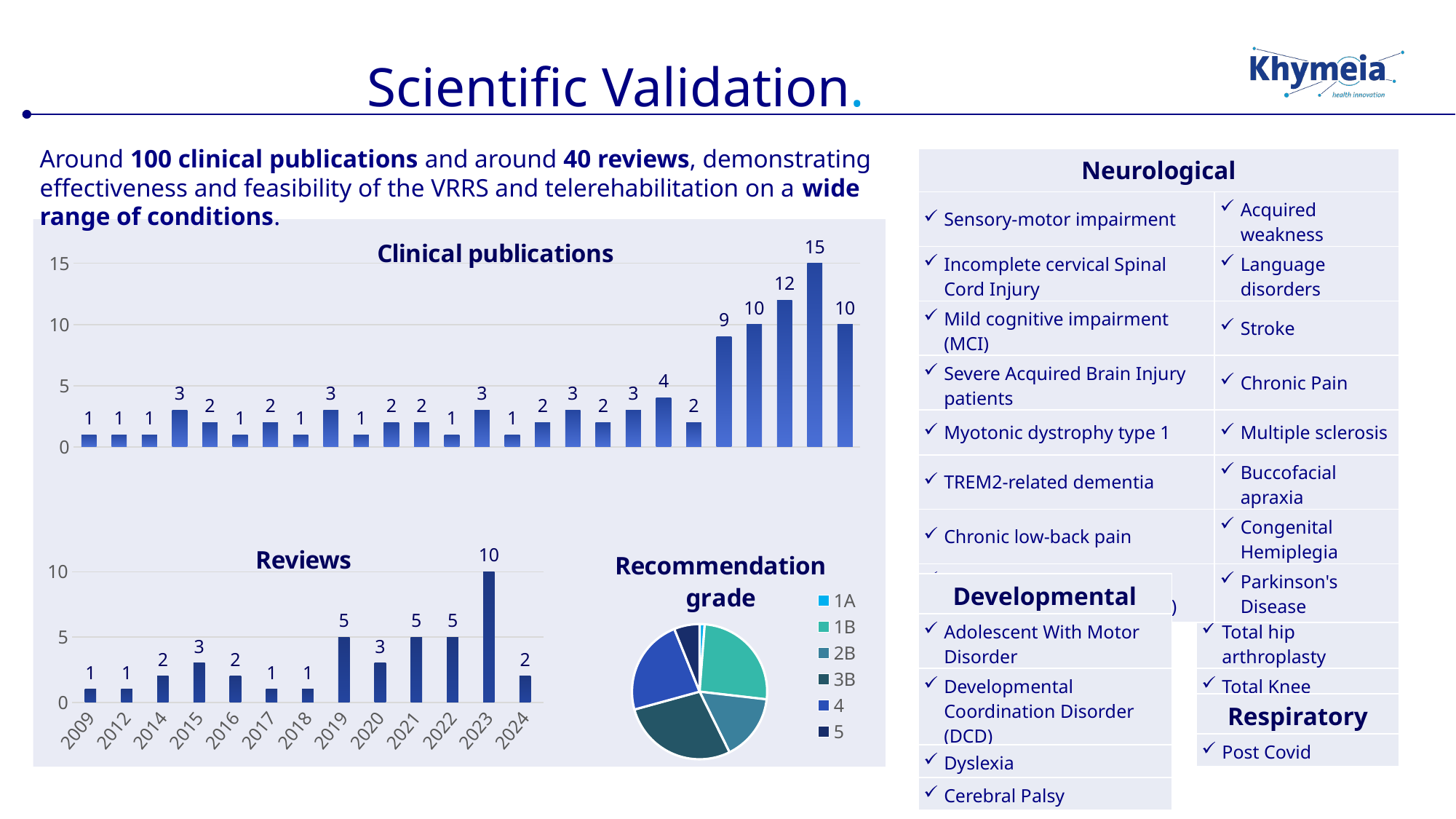
In the Reviews chart, which is larger, the value for 2015 or the value for 2020? They are equal (3) In the Reviews chart, which is larger, the value for 2014 or the value for 2021? 2021 How many entries does the legend of the Recommendation grade chart list? 6 In the Reviews chart, which year has the highest number of reviews? 2023 What kind of chart is the Clinical publications chart? Bar chart In the Reviews chart, what is the value for 2019? 5 In the Reviews chart, how many reviews are shown for 2023? 10 What kind of chart is the Recommendation grade chart? Pie chart In the Recommendation grade pie chart, which grade has the smallest slice? 1A In the Reviews chart, what is the difference between the values for 2023 and 2024? 8 How many years are shown on the x axis of the Reviews chart? 13 What is the highest value shown in the Clinical publications chart? 15